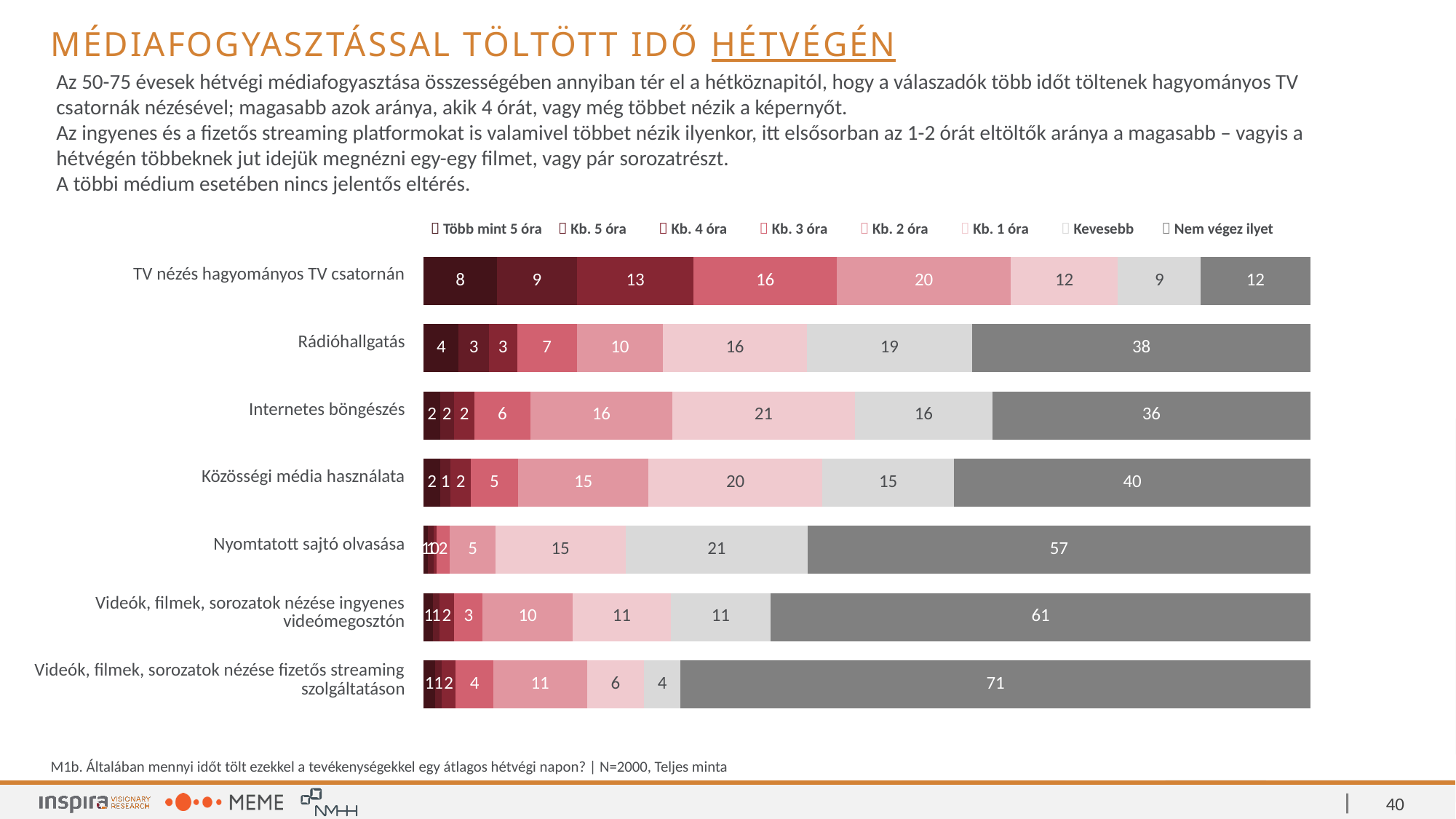
What kind of chart is shown on the slide? stacked bar chart How many categories (media activities) are plotted in the chart? 7 Which is larger: the "Kb. 3 óra" value for "TV nézés hagyományos TV csatornán" or for "Rádióhallgatás"? TV nézés hagyományos TV csatornán What is the value of "Nem végez ilyet" for "Rádióhallgatás"? 38 What is the value of "Nem végez ilyet" for "Videók, filmek, sorozatok nézése fizetős streaming szolgáltatáson"? 71 What is the value of "Kb. 2 óra" for "TV nézés hagyományos TV csatornán"? 20 What is the value of "Kb. 1 óra" for "Internetes böngészés"? 21 Which legend entry is shown in the darkest colour? Több mint 5 óra How many series does the legend list? 8 Which category has the highest "Nem végez ilyet" value? Videók, filmek, sorozatok nézése fizetős streaming szolgáltatáson What is the difference between the "Nem végez ilyet" values for "Nyomtatott sajtó olvasása" and "Közösségi média használata"? 17 Which category has the lowest "Nem végez ilyet" value? TV nézés hagyományos TV csatornán